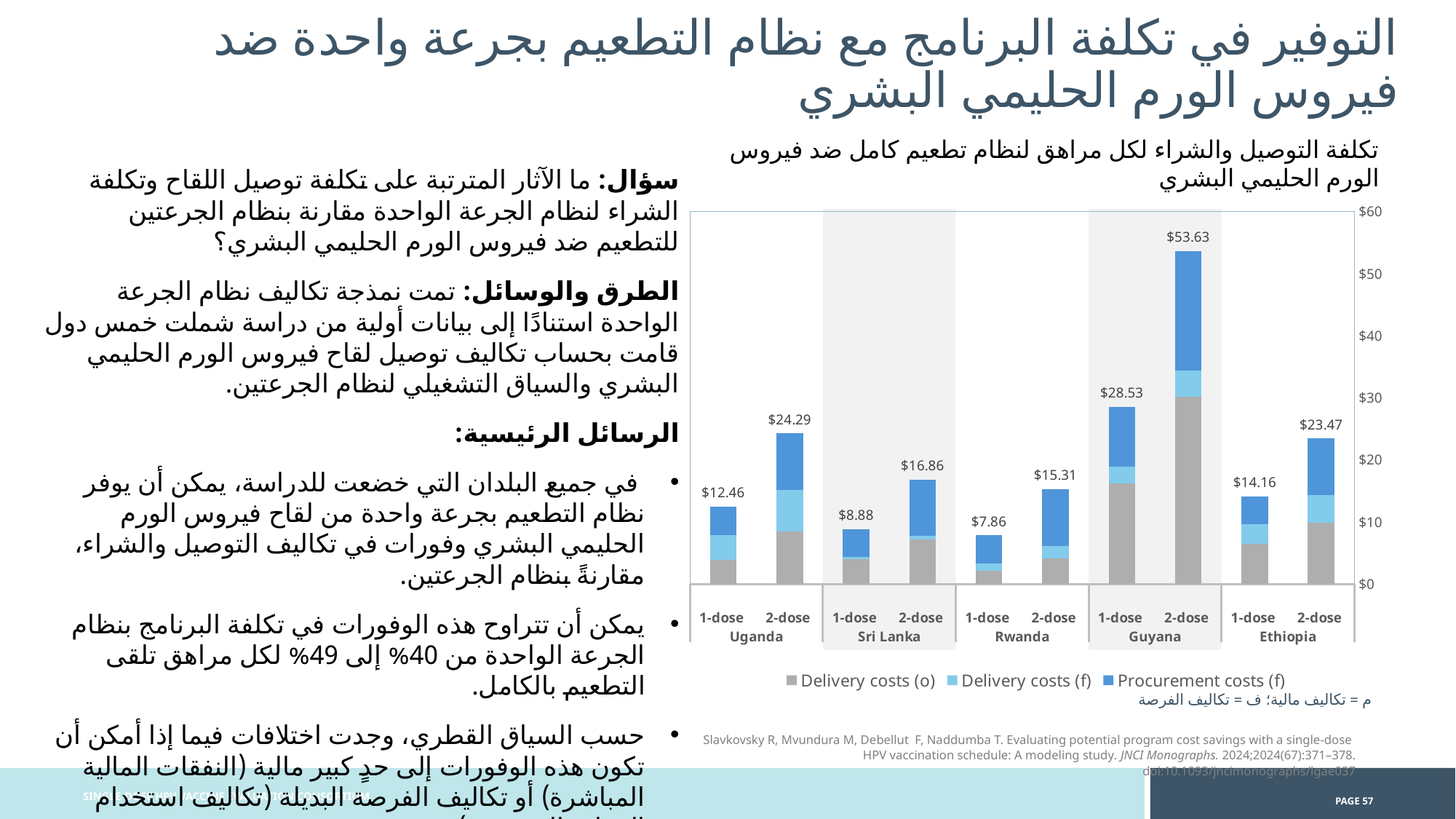
Which bar has the lowest total cost? Rwanda 1-dose What is the difference between the 2-dose and 1-dose total costs in Sri Lanka? $7.98 What is the total cost per fully immunized adolescent for the 2-dose schedule in Guyana? $53.63 What kind of chart is shown on the slide? Stacked bar chart How many series does the legend list? 3 Which is larger: the 2-dose total cost in Uganda or the 2-dose total cost in Ethiopia? Uganda 2-dose Is the total cost for the 1-dose schedule in Guyana greater or less than $20? greater What is the total cost per fully immunized adolescent for the 1-dose schedule in Uganda? $12.46 How many bars are plotted in the chart? 10 Which bar has the highest total cost? Guyana 2-dose What is the total cost for the 1-dose schedule in Rwanda? $7.86 What is the difference between the 2-dose and 1-dose total costs in Ethiopia? $9.31